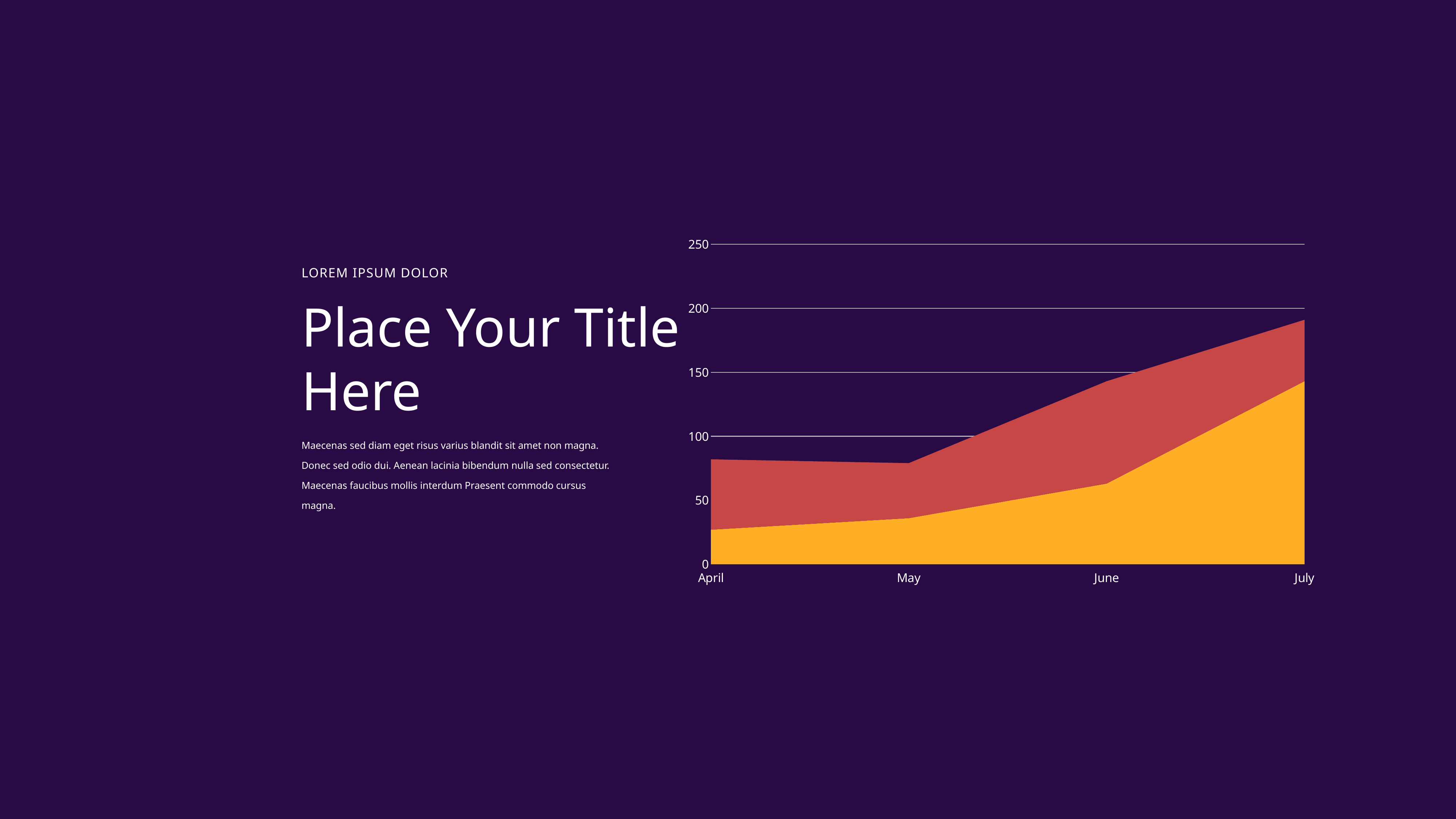
How many categories are shown on the x axis of the chart? 4 Which months are shown on the x axis of the chart? April, May, June, July Is the value of the yellow (bottom) series in July greater or less than 100? greater Does the yellow (bottom) series rise or fall from April to July? Rise Is the value of the yellow (bottom) series in April greater or less than 50? less Is the top of the stacked area in July greater or less than 150? greater In which month does the yellow (bottom) series reach its highest value? July How many data series are plotted in the area chart? 2 What kind of chart is shown on the slide? Area chart Which month has the larger value for the yellow (bottom) series, June or July? July